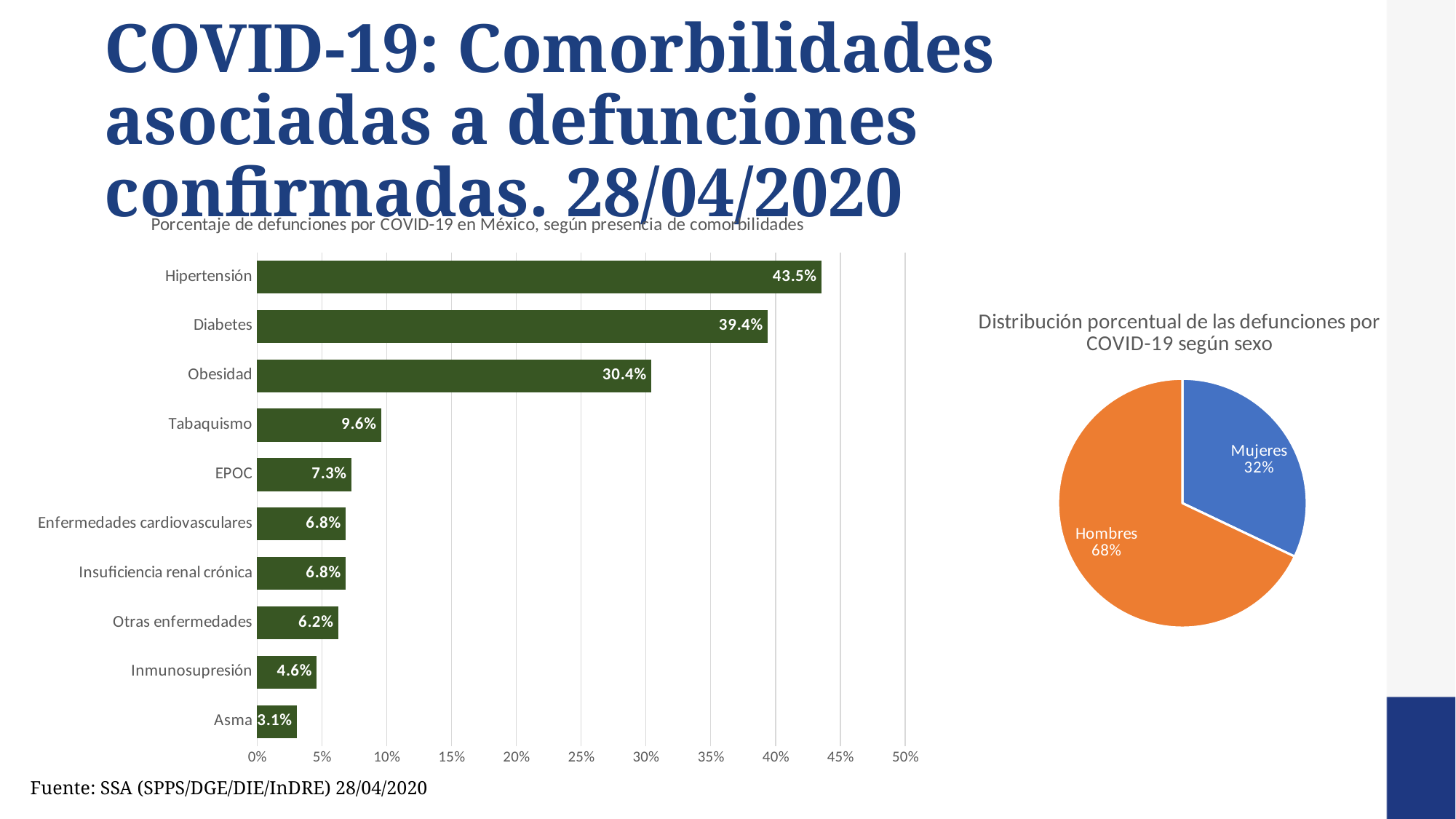
In the bar chart on the left, what is the difference between the values for Hipertensión and Diabetes? 4.1% In the bar chart on the left, what is the value for Tabaquismo? 9.6% In the pie chart on the right, what share of deaths corresponds to Hombres? 68% What is the title of the pie chart on the right? Distribución porcentual de las defunciones por COVID-19 según sexo In the bar chart on the left, which category has the lowest value? Asma In the pie chart on the right, what is the difference between the shares for Hombres and Mujeres? 36% In the pie chart on the right, what is the value for Mujeres? 32% What kind of chart is the chart on the left? Bar chart In the bar chart on the left, how many categories are shown? 10 In the bar chart on the left, what is the value for Hipertensión? 43.5% In the bar chart on the left, which category has the highest value? Hipertensión In the bar chart on the left, which is larger, the value for Obesidad or the value for EPOC? Obesidad